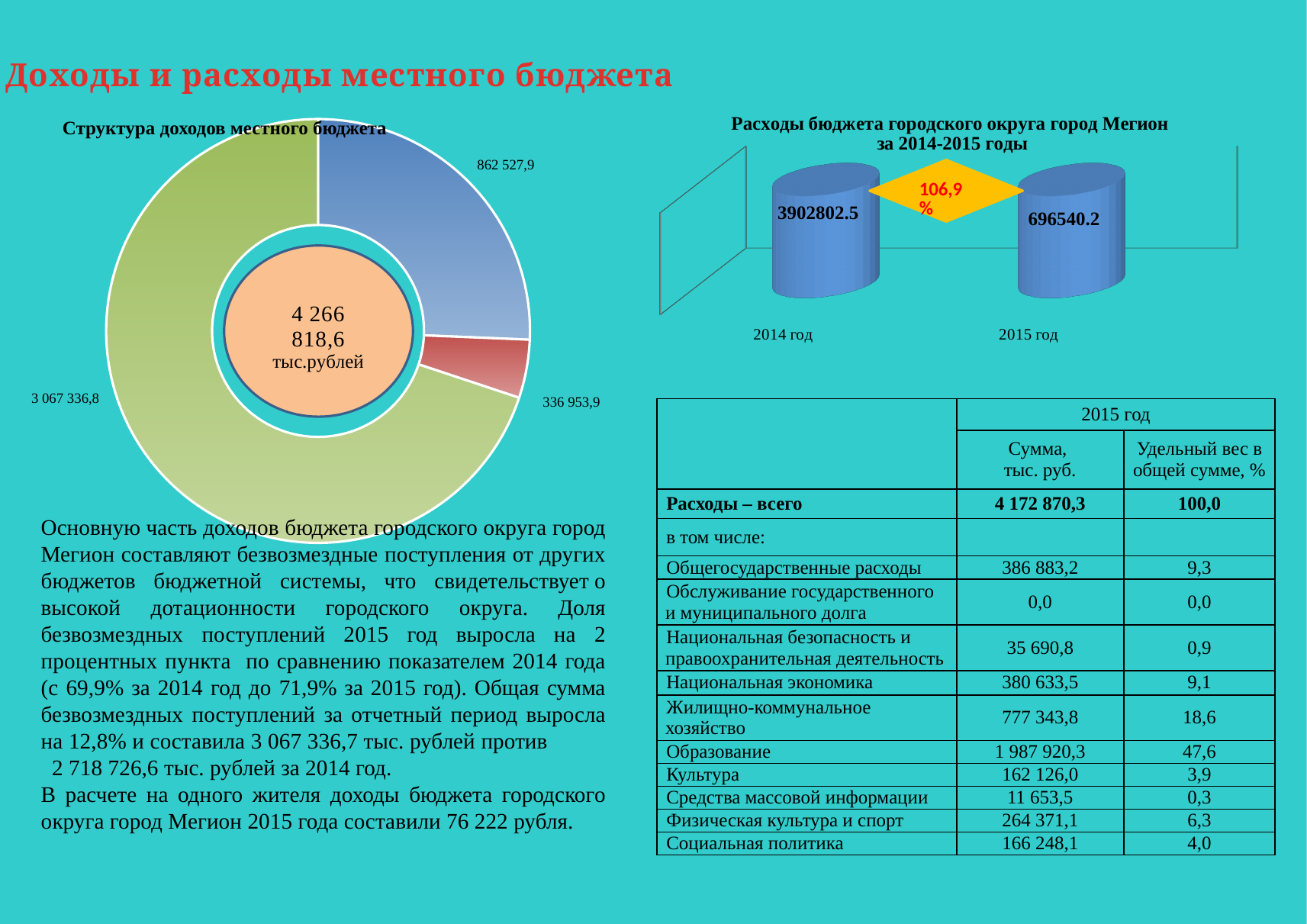
In the chart 'Расходы бюджета городского округа город Мегион за 2014-2015 годы', what is the value for 2015 год? 696540.2 What kind of chart is 'Расходы бюджета городского округа город Мегион за 2014-2015 годы'? bar chart What percentage is shown in the yellow diamond in the chart 'Расходы бюджета городского округа город Мегион за 2014-2015 годы'? 106,9 % In the chart 'Расходы бюджета городского округа город Мегион за 2014-2015 годы', what is the value for 2014 год? 3902802.5 What kind of chart is 'Структура доходов местного бюджета'? doughnut chart How many slices does the chart 'Структура доходов местного бюджета' have? 3 In the chart 'Структура доходов местного бюджета', what is the value of the largest slice? 3 067 336,8 In the chart 'Структура доходов местного бюджета', what is the value of the smallest slice? 336 953,9 How many categories are shown in the chart 'Расходы бюджета городского округа город Мегион за 2014-2015 годы'? 2 What total value is shown in the centre of the chart 'Структура доходов местного бюджета'? 4 266 818,6 тыс.рублей In the chart 'Структура доходов местного бюджета', what share of the total does the largest slice (3 067 336,8) represent? 71,9% In the chart 'Структура доходов местного бюджета', what is the difference between the blue slice (862 527,9) and the red slice (336 953,9)? 525 574,0